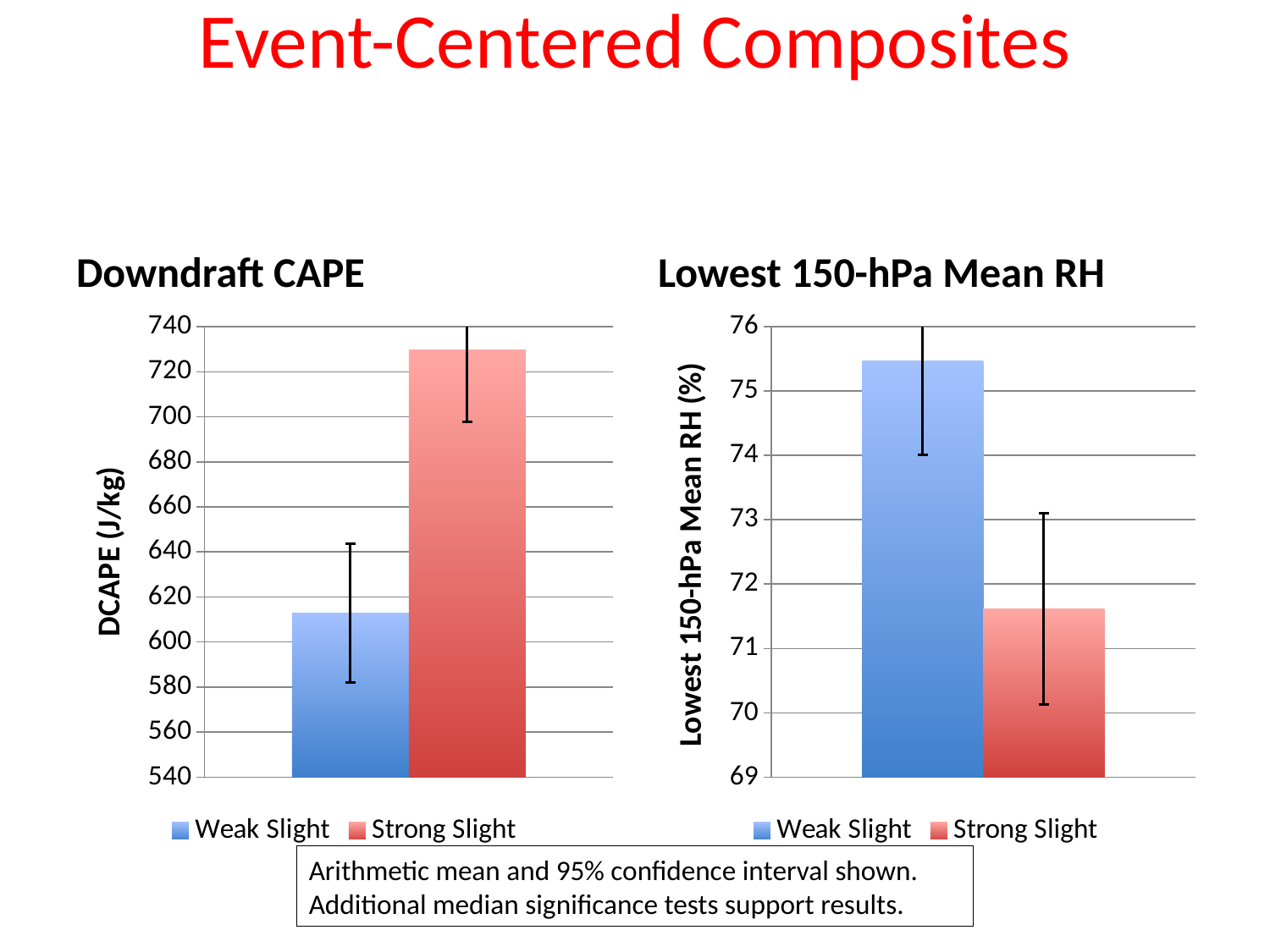
In the Lowest 150-hPa Mean RH chart, is the value for Weak Slight greater or less than 75? greater How many bars are plotted in the Lowest 150-hPa Mean RH chart? 2 In the Downdraft CAPE chart, which series has the higher value, Weak Slight or Strong Slight? Strong Slight In the Lowest 150-hPa Mean RH chart, which series has the lower value? Strong Slight In the Downdraft CAPE chart, is the value for Weak Slight greater or less than 640? less How many series does the legend of the Downdraft CAPE chart list? 2 What kind of chart is the Lowest 150-hPa Mean RH chart? bar chart In the Lowest 150-hPa Mean RH chart, is the value for Strong Slight greater or less than 72? less What is the y-axis label of the Downdraft CAPE chart? DCAPE (J/kg) What kind of chart is the Downdraft CAPE chart? bar chart What colour is the Weak Slight series in the Lowest 150-hPa Mean RH chart? blue